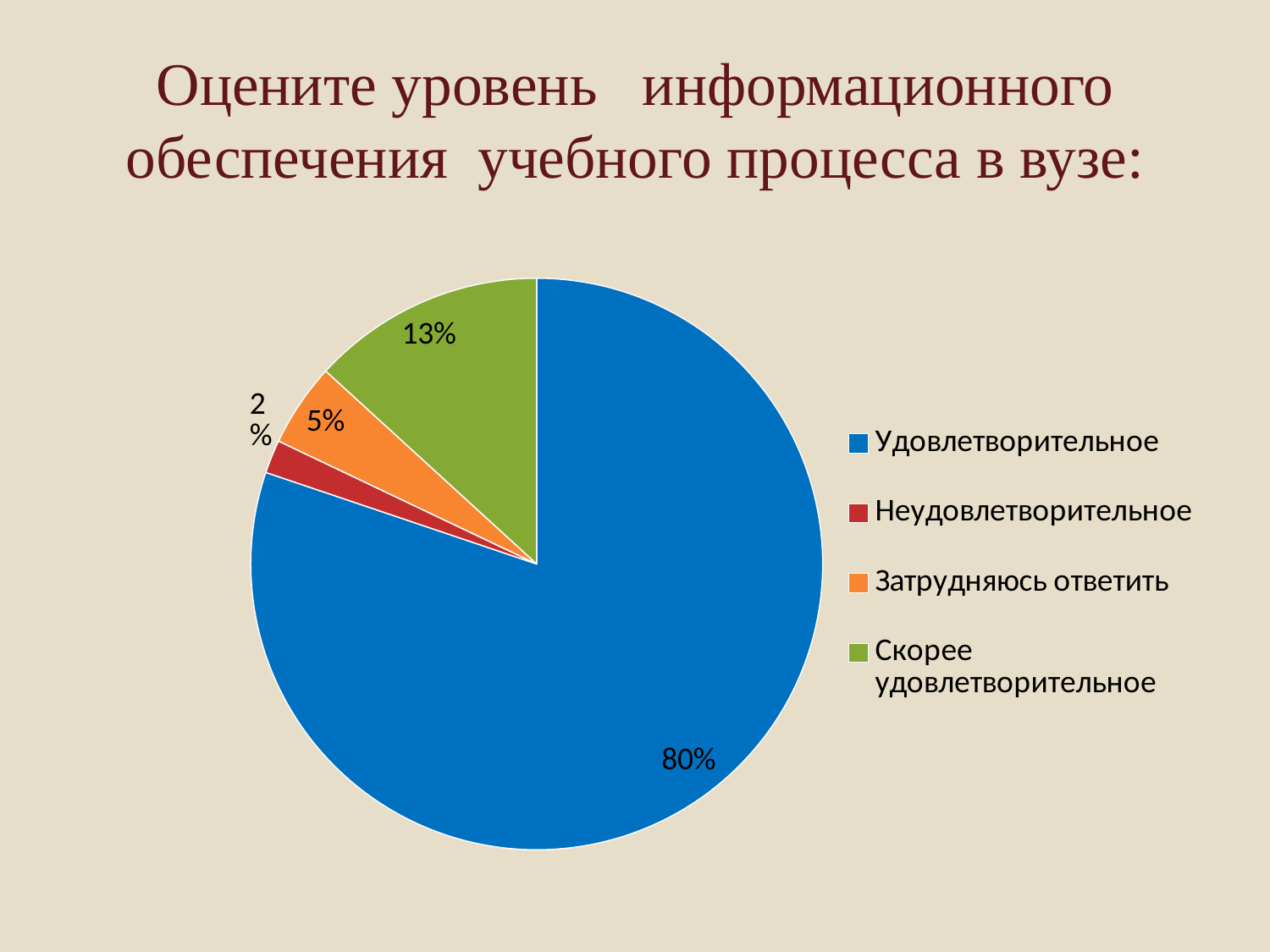
Which category has the smallest slice of the pie? Неудовлетворительное What share of the pie does "Скорее удовлетворительное" have? 13% What colour is the slice for "Затрудняюсь ответить"? orange How many categories does the pie chart have? 4 What kind of chart is shown on the slide? pie chart What is the difference between the shares of "Удовлетворительное" and "Скорее удовлетворительное"? 67% What share of the pie does "Неудовлетворительное" have? 2% What is the difference between the shares of "Затрудняюсь ответить" and "Неудовлетворительное"? 3% Which is larger: the share of "Скорее удовлетворительное" or the share of "Затрудняюсь ответить"? Скорее удовлетворительное What share of the pie does "Удовлетворительное" have? 80% Which category has the largest slice of the pie? Удовлетворительное